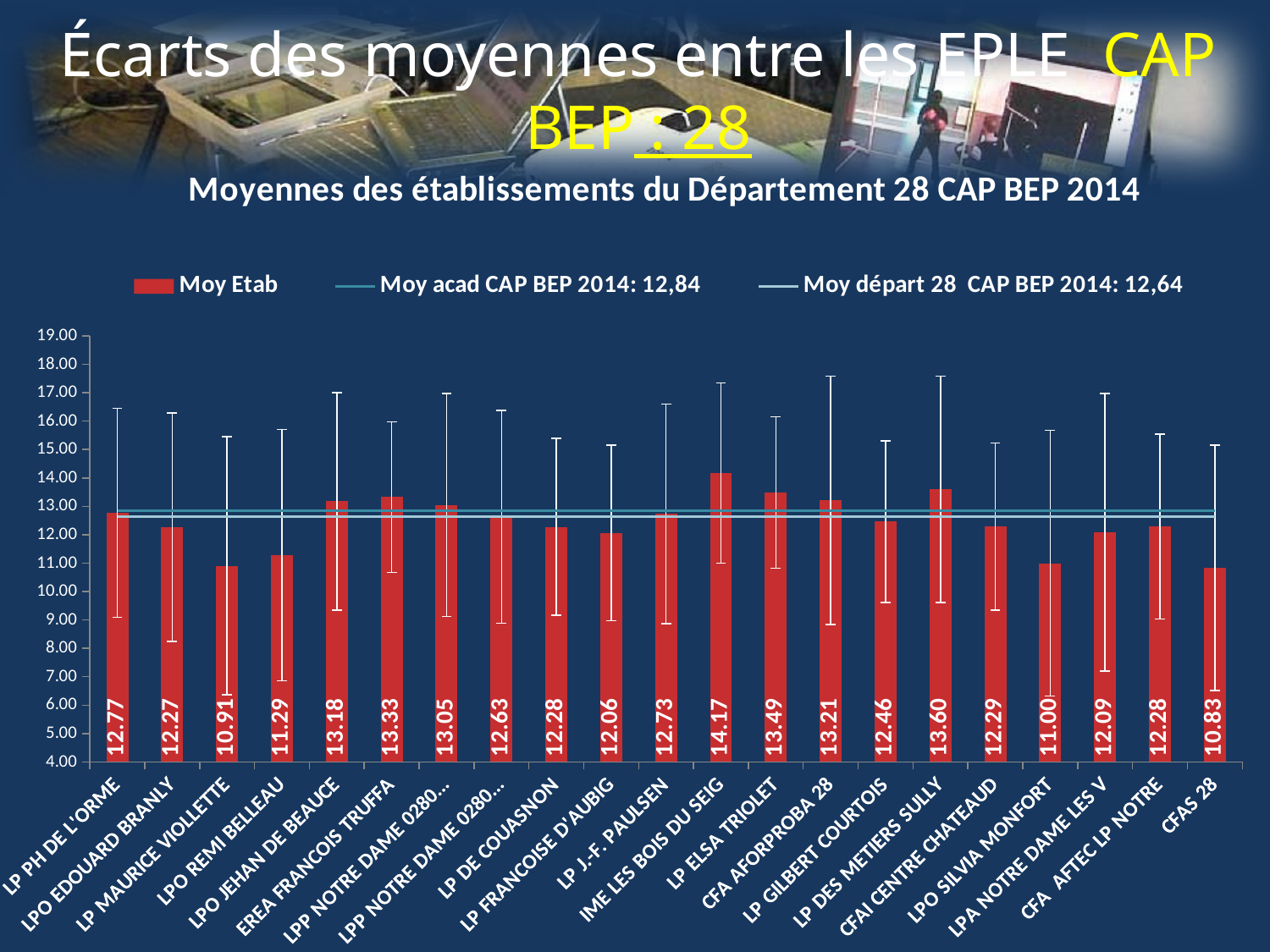
What value does the legend give for Moy acad CAP BEP 2014? 12,84 What is the Moy Etab value for CFA AFORPROBA 28? 13.21 How many series does the legend list? 3 Which establishment has the highest Moy Etab value? IME LES BOIS DU SEIG What is the difference between the Moy Etab values of IME LES BOIS DU SEIG and CFAS 28? 3.34 What is the Moy Etab value for LPO REMI BELLEAU? 11.29 What is the Moy Etab value for LP ELSA TRIOLET? 13.49 Which has a higher Moy Etab value, EREA FRANCOIS TRUFFA or LPO JEHAN DE BEAUCE? EREA FRANCOIS TRUFFA What kind of chart is used to show the Moy Etab values? Bar chart How many establishments are shown on the x axis? 21 What is the difference between the Moy Etab values of LP DES METIERS SULLY and LP MAURICE VIOLLETTE? 2.69 Which establishment has the lowest Moy Etab value? CFAS 28